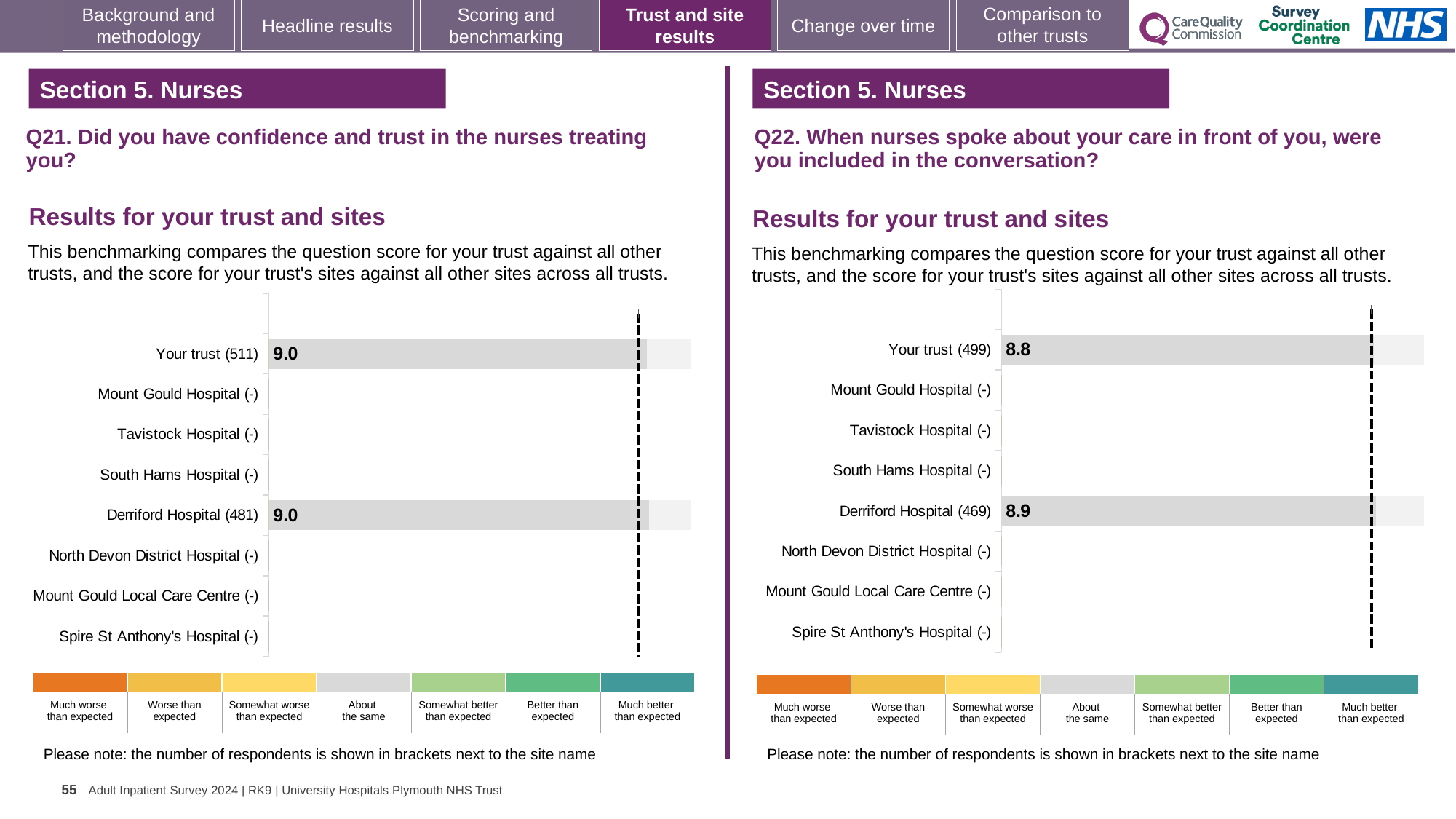
How many site categories are listed on the y axis of the Q21 chart on the left? 8 In the Q22 chart on the right, what is the difference between the Derriford Hospital score and the Your trust score? 0.1 In the Q21 chart on the left, what is the score for Your trust? 9.0 In the Q22 chart on the right, what is the score for Your trust? 8.8 In the Q22 chart on the right, how many respondents are shown in brackets for Derriford Hospital? 469 In the Q21 chart on the left, how many respondents are shown in brackets for Your trust? 511 What kind of chart is used for the Q22 results on the right? Bar chart In the Q22 chart on the right, which has the higher score, Your trust or Derriford Hospital? Derriford Hospital In the Q22 chart on the right, what is the score for Derriford Hospital? 8.9 In the Q21 chart on the left, how many sites have a plotted bar? 2 In the Q21 chart on the left, what is the score for Derriford Hospital? 9.0